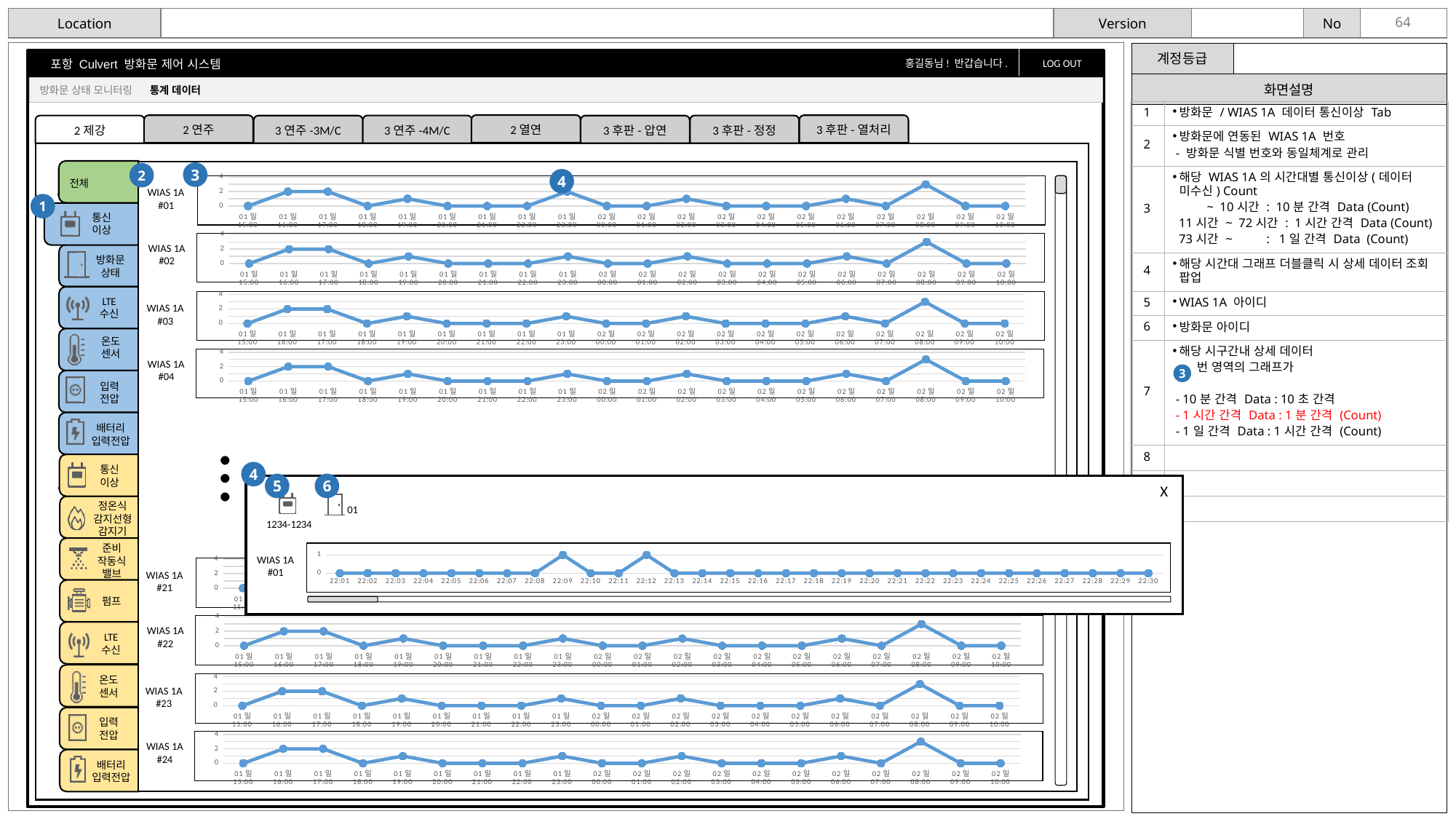
What kind of chart is the WIAS 1A #01 chart in the popup window? line chart In the popup WIAS 1A #01 chart, what is the value at 22:09? 1 In the popup WIAS 1A #01 chart, how many time points are plotted along the x axis? 30 In the popup WIAS 1A #01 chart, what is the value at 22:05? 0 In the top WIAS 1A #01 chart (main screen), which is larger, the value at 01일 16:00 or the value at 01일 18:00? 01일 16:00 In the popup WIAS 1A #01 chart, what is the first time label on the x axis? 22:01 In the popup WIAS 1A #01 chart, at which times does the value reach its highest point? 22:09 and 22:12 In the top WIAS 1A #01 chart (main screen), what is the value at 01일 15:00? 0 In the top WIAS 1A #01 chart (main screen), at which time is the value highest? 02일 08:00 In the popup WIAS 1A #01 chart, which is larger, the value at 22:12 or the value at 22:13? 22:12 In the top WIAS 1A #01 chart (main screen), is the value at 02일 08:00 greater or less than 2? greater In the top WIAS 1A #01 chart (main screen), how many time points are plotted along the x axis? 20